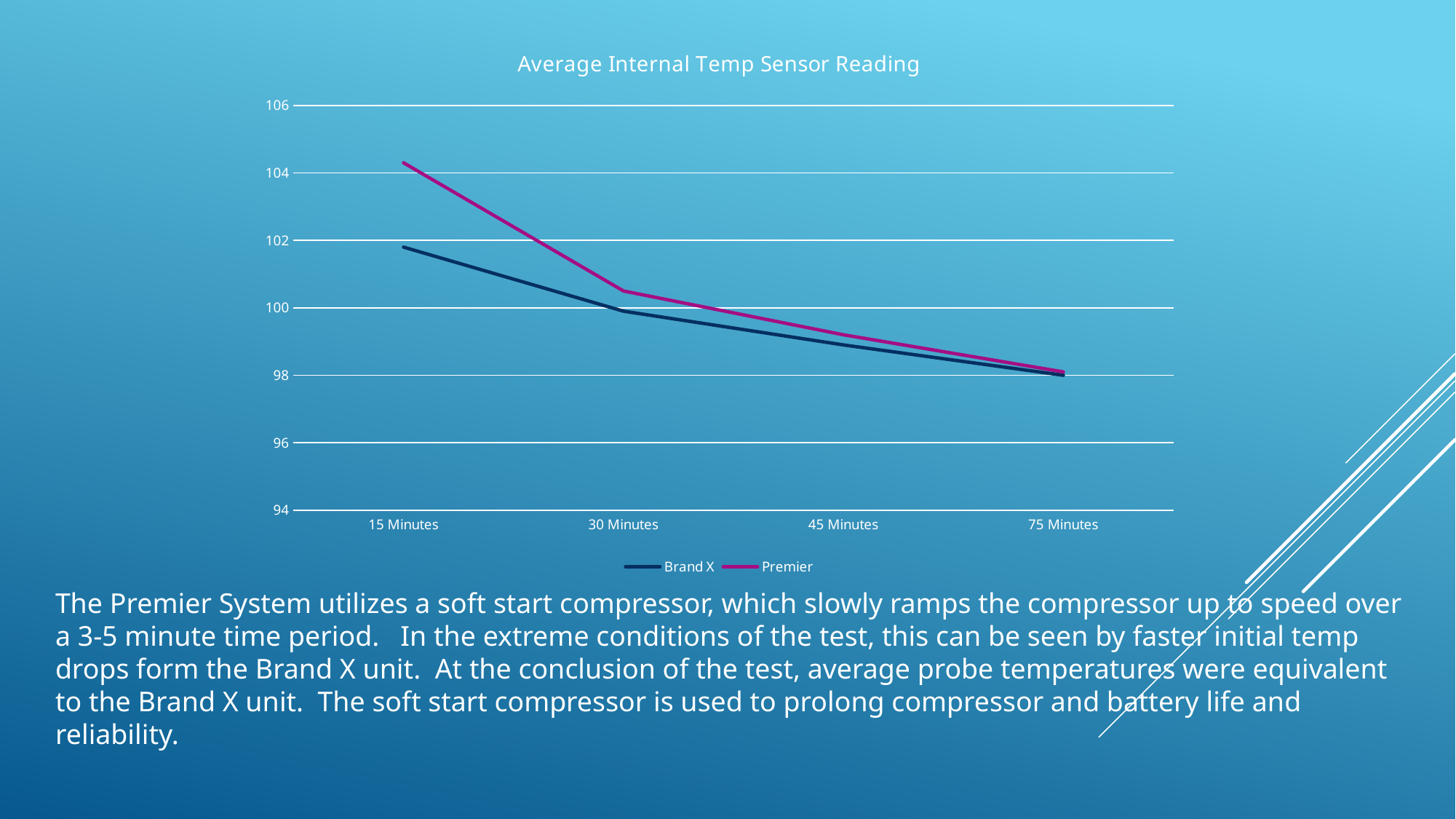
At which time point does the Premier series reach its highest reading? 15 Minutes Is the Premier value at 75 Minutes greater or less than 100? less At 15 Minutes, which series has the higher reading, Brand X or Premier? Premier How many series does the legend list? 2 Is the Premier value at 15 Minutes greater or less than 102? greater Do the Premier readings rise or fall from 15 Minutes to 75 Minutes? fall How many time points are shown on the x axis? 4 Is the Brand X value at 45 Minutes greater or less than 100? less Which series is drawn in the magenta line? Premier What kind of chart is shown on the slide? line chart What is the title of the chart? Average Internal Temp Sensor Reading